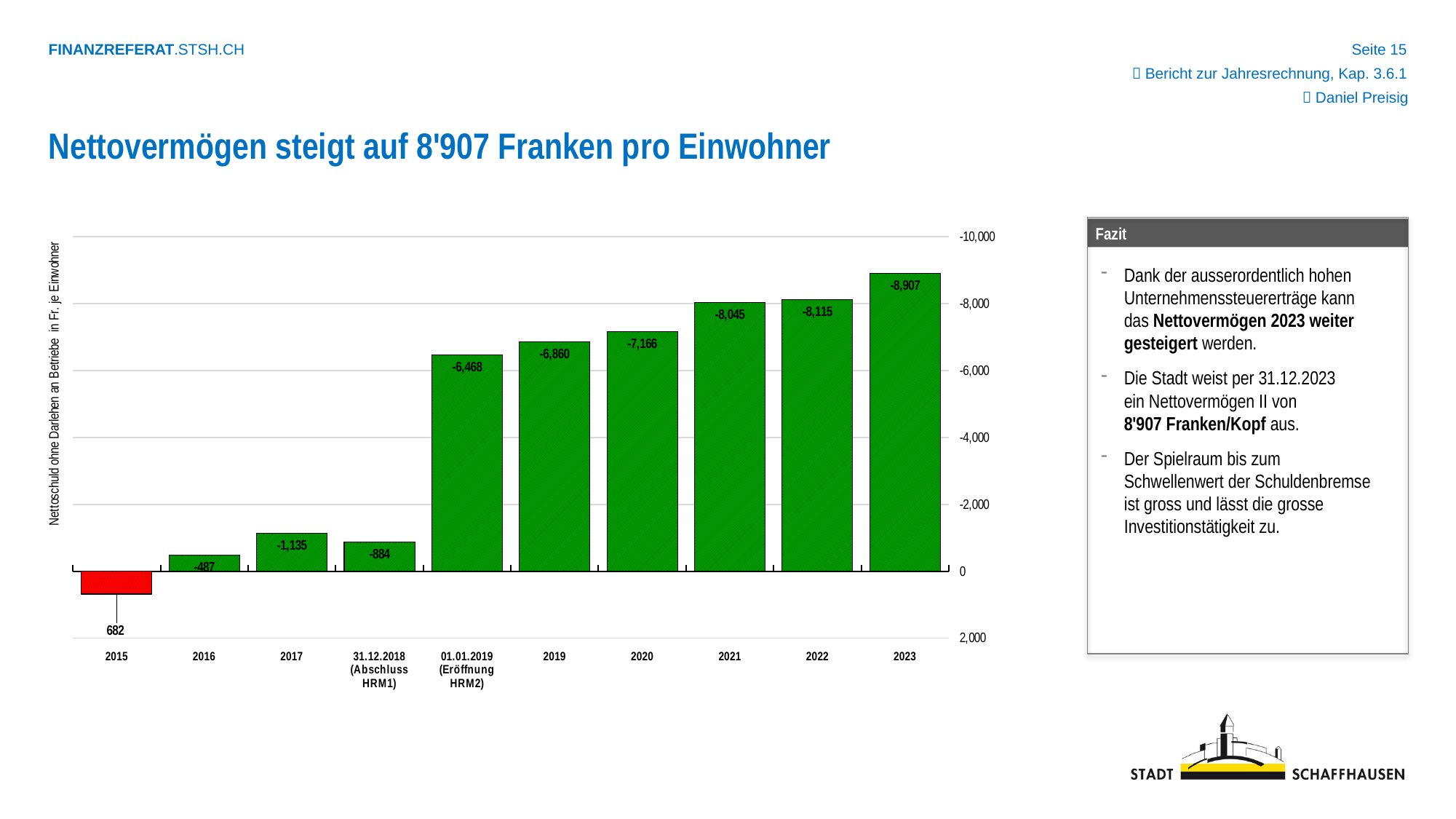
What is the value shown for 31.12.2018 (Abschluss HRM1)? -884 Which category is the only one with a positive value? 2015 By how much does the value change from 2022 (-8,115) to 2023 (-8,907)? -792 What is the value shown for 01.01.2019 (Eröffnung HRM2)? -6,468 What kind of chart is shown on the slide? Bar chart Which has the larger absolute value, 2019 or 2020? 2020 How many categories are shown on the x axis? 10 What is the value shown for 2015? 682 What is the difference between the values for 2020 (-7,166) and 2021 (-8,045)? 879 Which category has the most negative value (the tallest bar)? 2023 What is the value shown for 2023? -8,907 Which bar is coloured red instead of green? 2015